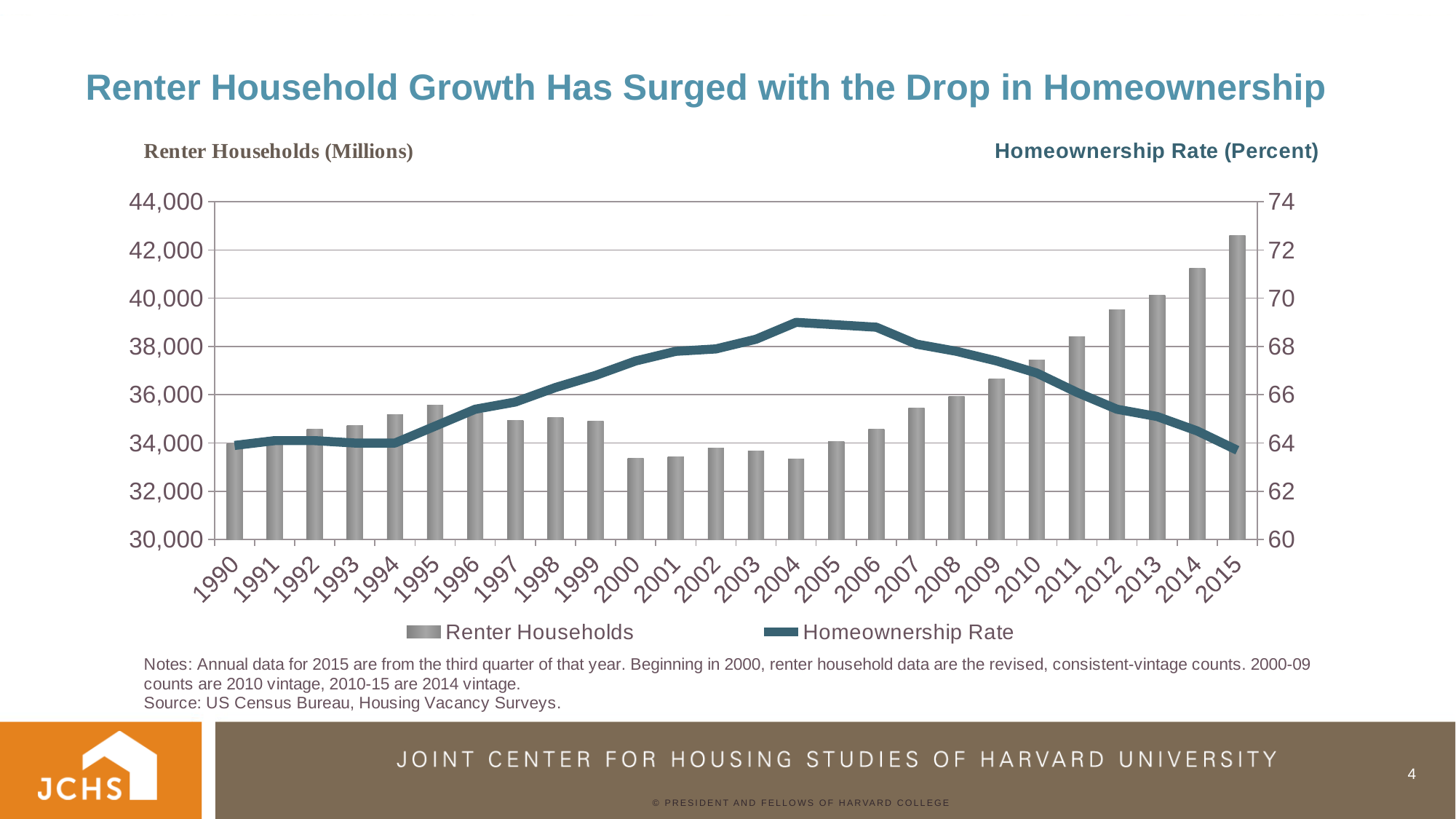
How many years are shown along the x axis? 26 Is the value for Renter Households in 2004 greater or less than 34,000? less Does the Homeownership Rate rise or fall from 2004 to 2015? It falls What is the title of the right-hand axis? Homeownership Rate (Percent) Which year has the highest number of renter households? 2015 Which year has more renter households, 1990 or 2015? 2015 Is the value for Renter Households in 2015 greater or less than 42,000? greater Is the Homeownership Rate in 2012 greater or less than 66? less What kind of chart is shown on the slide? A combined bar and line chart How many series does the legend list? 2